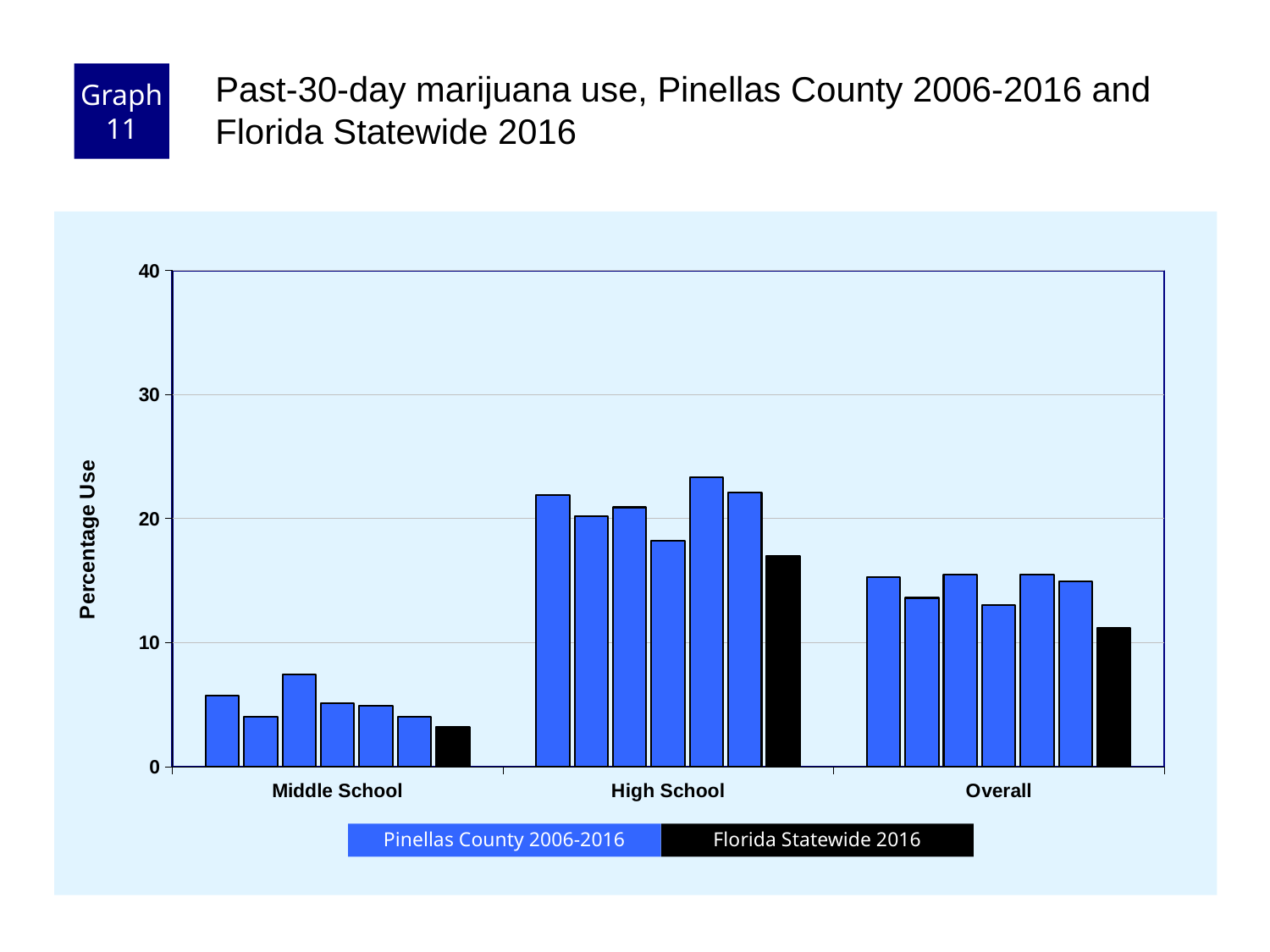
Which category has the lowest past-30-day marijuana use values? Middle School Which is larger, the Florida Statewide 2016 value for High School or for Overall? High School Is the Florida Statewide 2016 value for High School greater or less than 20? less How many school-level categories are shown along the x axis? 3 Is the Florida Statewide 2016 value for Middle School greater or less than 10? less What is the label on the y axis? Percentage Use Is the Florida Statewide 2016 value for High School greater or less than 10? greater What colour are the Florida Statewide 2016 bars? black Which category has the highest past-30-day marijuana use values? High School What kind of chart is shown on the slide? bar chart How many series does the legend list? 2